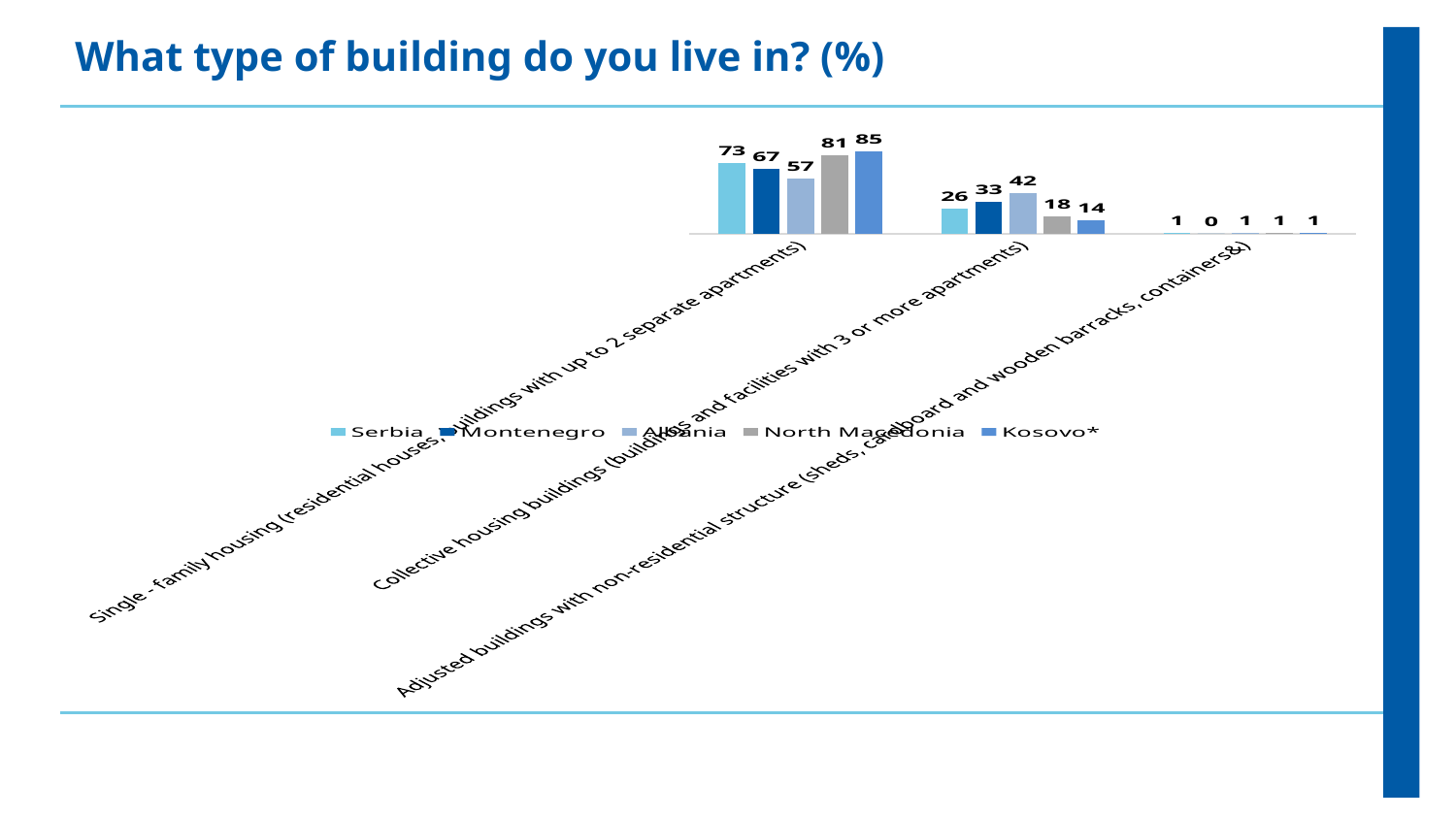
What kind of chart is shown on the slide? Bar chart Which country has the highest value for single-family housing? Kosovo* What is the value for Montenegro in the adjusted buildings with non-residential structure category? 0 Which country has the lowest value for collective housing buildings? Kosovo* What is the title of the chart? What type of building do you live in? (%) What is the value for Albania in the collective housing buildings category? 42 Which is larger for collective housing buildings: Serbia or Montenegro? Montenegro What is the difference between North Macedonia and Albania in the single-family housing category? 24 What is the value for Kosovo* in the single-family housing category? 85 What is the difference between Serbia's values for single-family housing and collective housing buildings? 47 How many building-type categories are shown on the x axis? 3 How many series does the legend list? 5